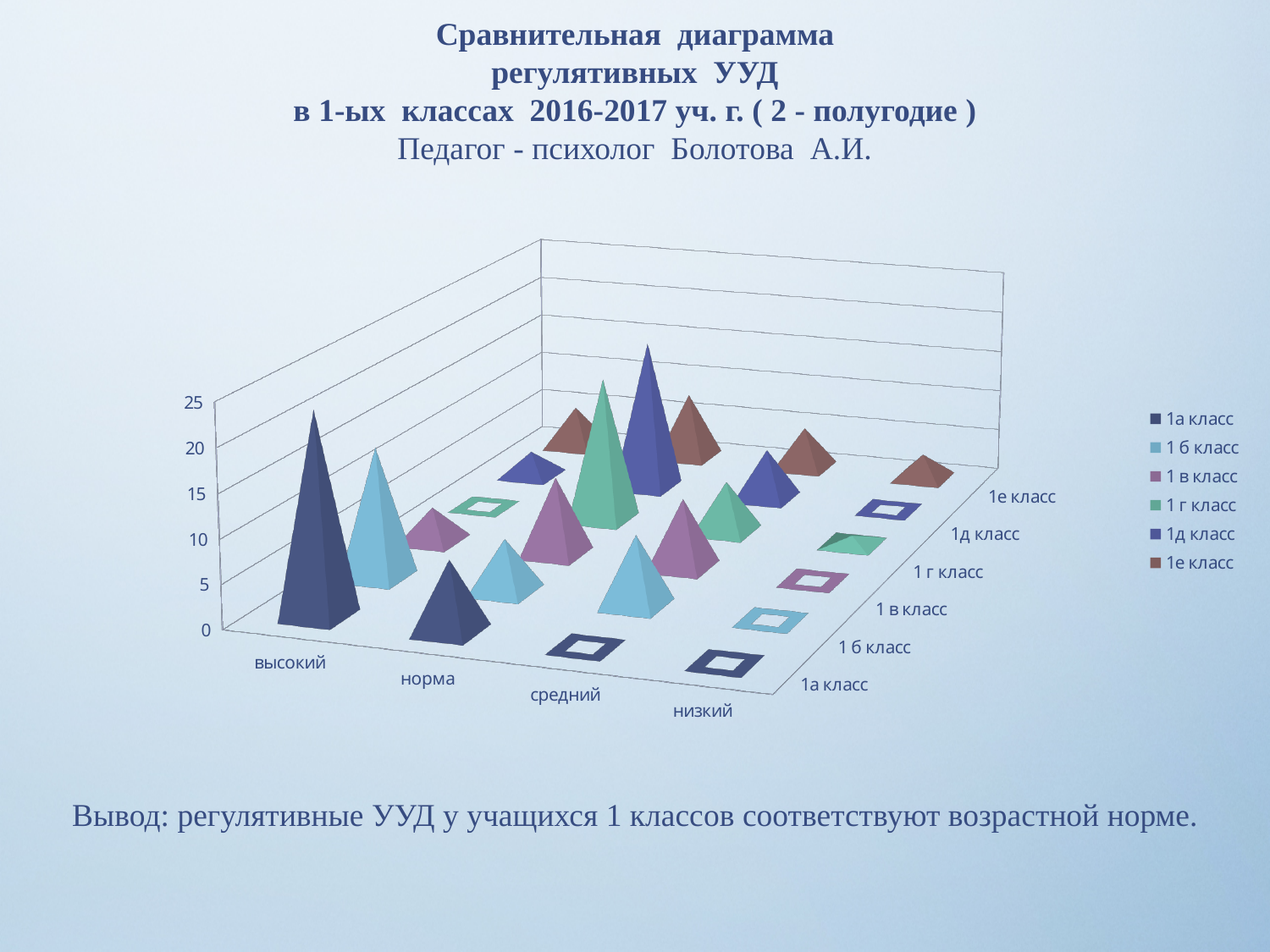
Which series is listed last in the chart's legend? 1е класс How many categories are shown along the horizontal axis of the chart? 4 Is the value for 1а класс in the высокий category greater or less than 15? greater What kind of chart is shown on the slide? bar chart Do the values for 1а класс rise or fall from высокий to низкий along the horizontal axis? fall Is the value for 1 б класс in the низкий category greater or less than 5? less Which category is listed first on the horizontal axis of the chart? высокий Which class has the highest value in the высокий category? 1а класс Which is larger for 1а класс: the value for высокий or the value for норма? высокий How many series does the chart's legend list? 6 For 1а класс, which category has the highest value? высокий Is the value for 1а класс in the низкий category greater or less than 5? less